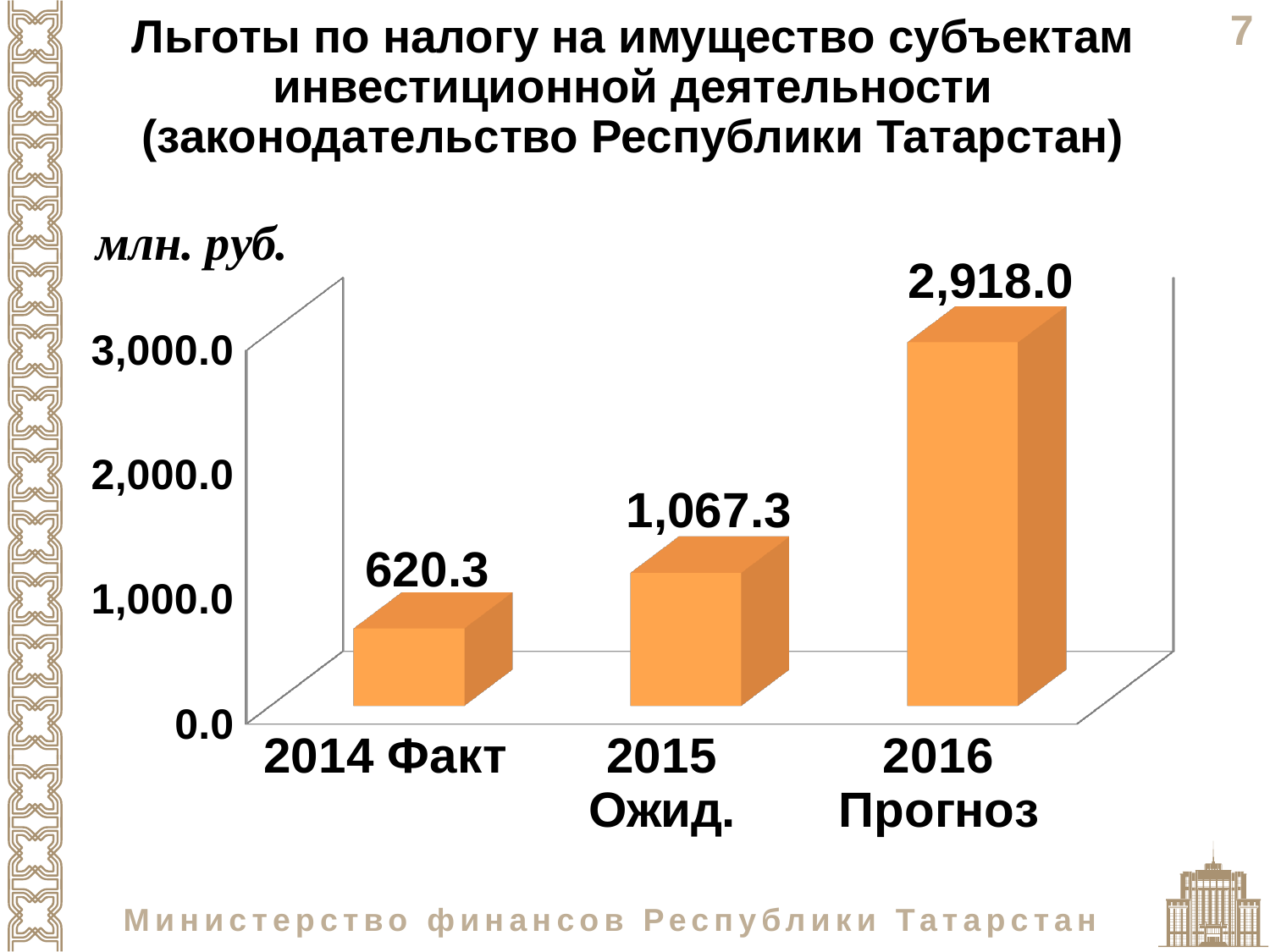
What is the value for 2016 Прогноз? 2,918.0 What is the difference between the values for 2015 Ожид. and 2014 Факт? 447.0 Is the value for 2016 Прогноз greater or less than 2,000.0? greater Do the values rise or fall from 2014 Факт to 2016 Прогноз? rise Which category has the highest value? 2016 Прогноз What kind of chart is shown on the slide? bar chart Which category has the lowest value? 2014 Факт What is the value for 2015 Ожид.? 1,067.3 What is the difference between the values for 2016 Прогноз and 2015 Ожид.? 1,850.7 How many categories are shown on the x axis? 3 What is the value for 2014 Факт? 620.3 Which is larger, the value for 2015 Ожид. or the value for 2014 Факт? 2015 Ожид.